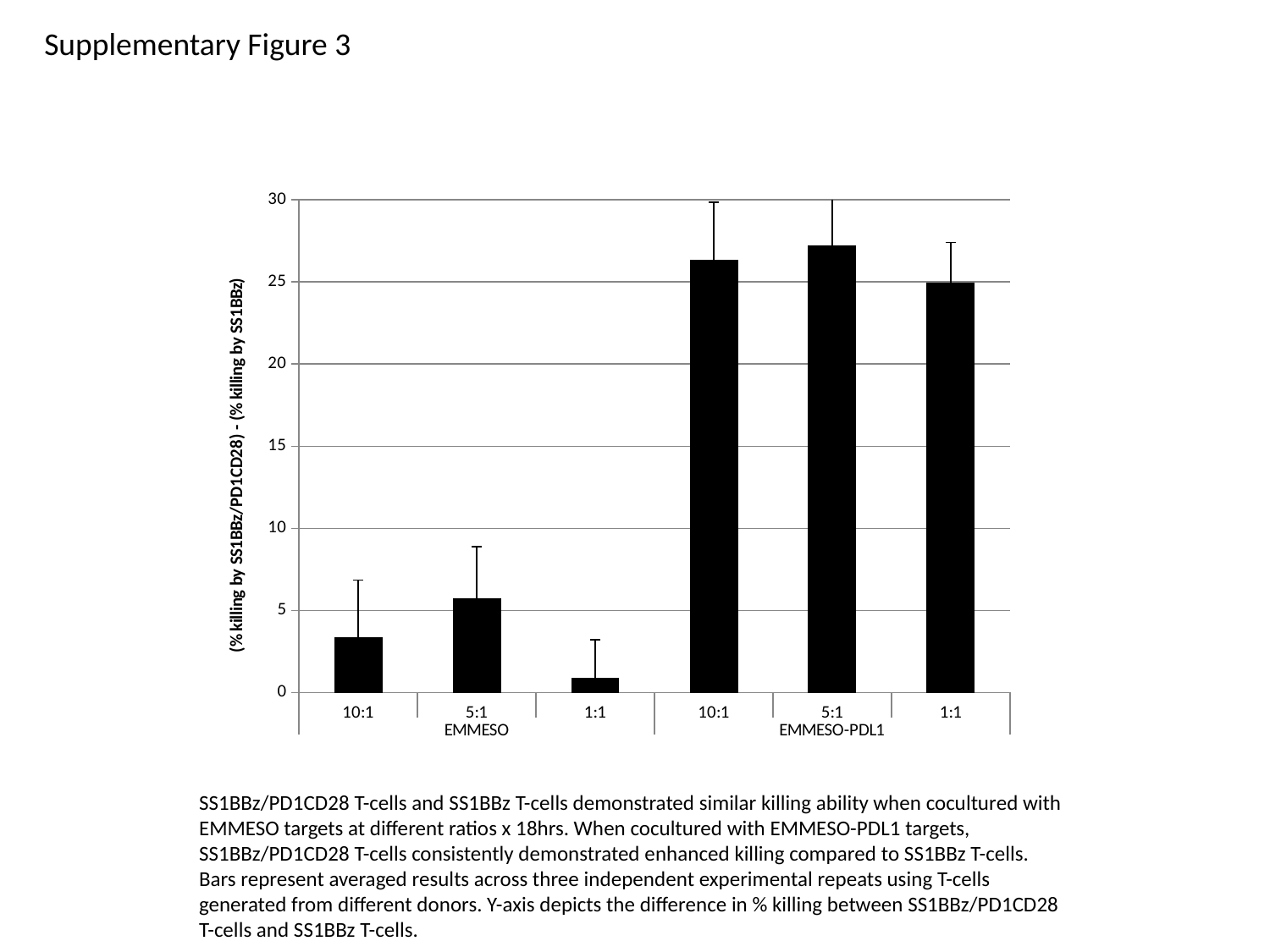
Is the value for the EMMESO 1:1 bar greater or less than 5? less Which is larger, the EMMESO 5:1 bar or the EMMESO 10:1 bar? EMMESO 5:1 What are the two target groups labelled on the x axis of the chart? EMMESO and EMMESO-PDL1 What kind of chart is shown on the slide? bar chart Which bar has the lowest value in the chart? EMMESO 1:1 Is the value for the EMMESO 10:1 bar greater or less than 5? less Is the value for the EMMESO-PDL1 5:1 bar greater or less than 25? greater How many bars are plotted in the chart? 6 Which is larger, the 10:1 bar for EMMESO or the 10:1 bar for EMMESO-PDL1? EMMESO-PDL1